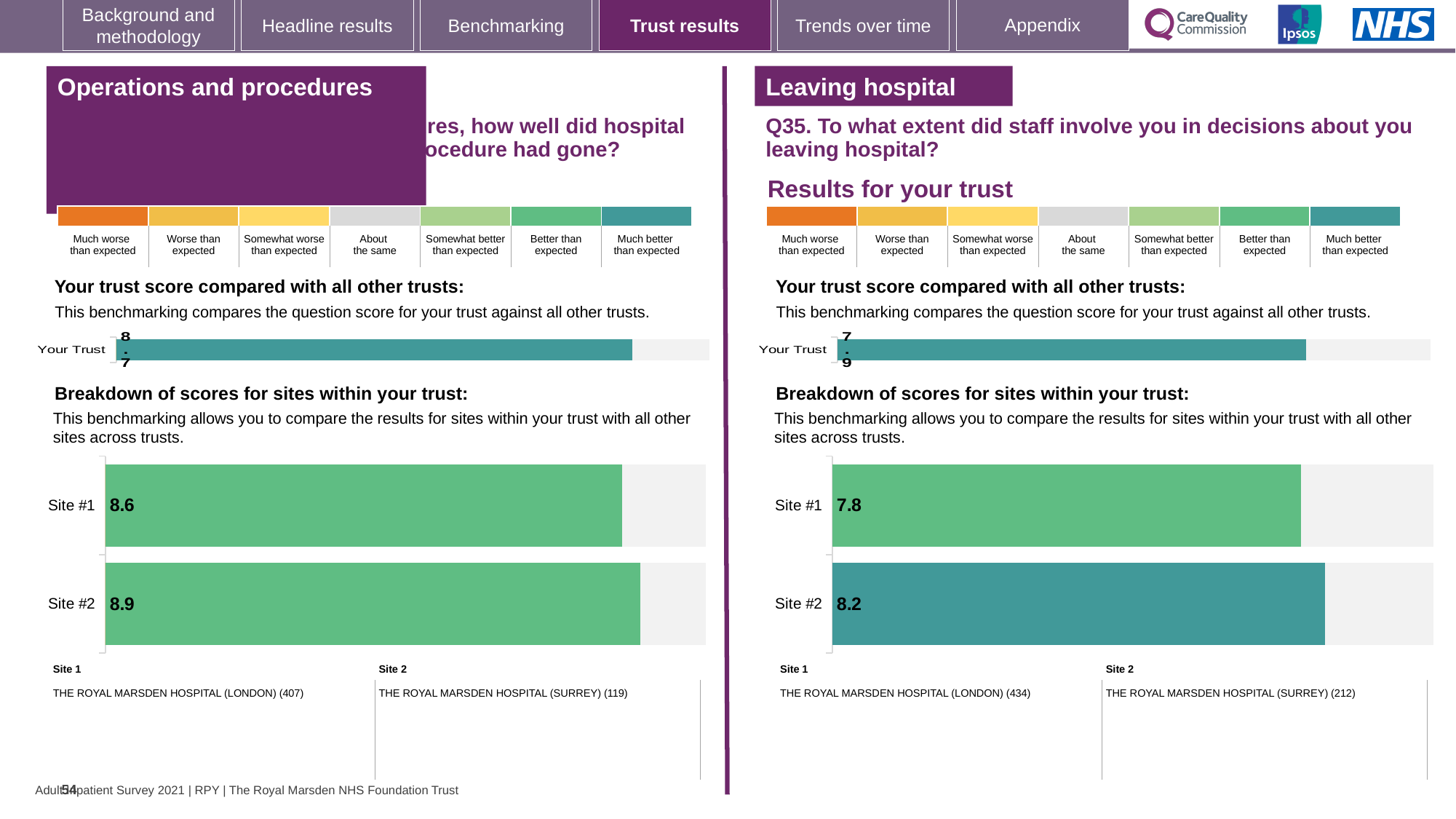
In the 'Leaving hospital' site breakdown chart, which site has the higher score? Site #2 In the 'Operations and procedures' site breakdown chart, what is the score for Site #1? 8.6 In the 'Operations and procedures' site breakdown chart, which site has the lower score? Site #1 In the 'Leaving hospital' site breakdown chart, what is the score for Site #2? 8.2 In the 'Operations and procedures' 'Your trust score compared with all other trusts' chart, what is the score for Your Trust? 8.7 In the 'Operations and procedures' site breakdown chart, what is the difference between the Site #2 and Site #1 scores? 0.3 In the 'Leaving hospital' site breakdown chart, what is the score for Site #1? 7.8 In the 'Leaving hospital' site breakdown chart, what is the difference between the Site #2 and Site #1 scores? 0.4 In the 'Leaving hospital' 'Your trust score compared with all other trusts' chart, what is the score for Your Trust? 7.9 How many sites are shown in the 'Leaving hospital' site breakdown chart? 2 What kind of chart is used for the site breakdown under 'Operations and procedures'? Bar chart In the 'Operations and procedures' site breakdown chart, what is the score for Site #2? 8.9